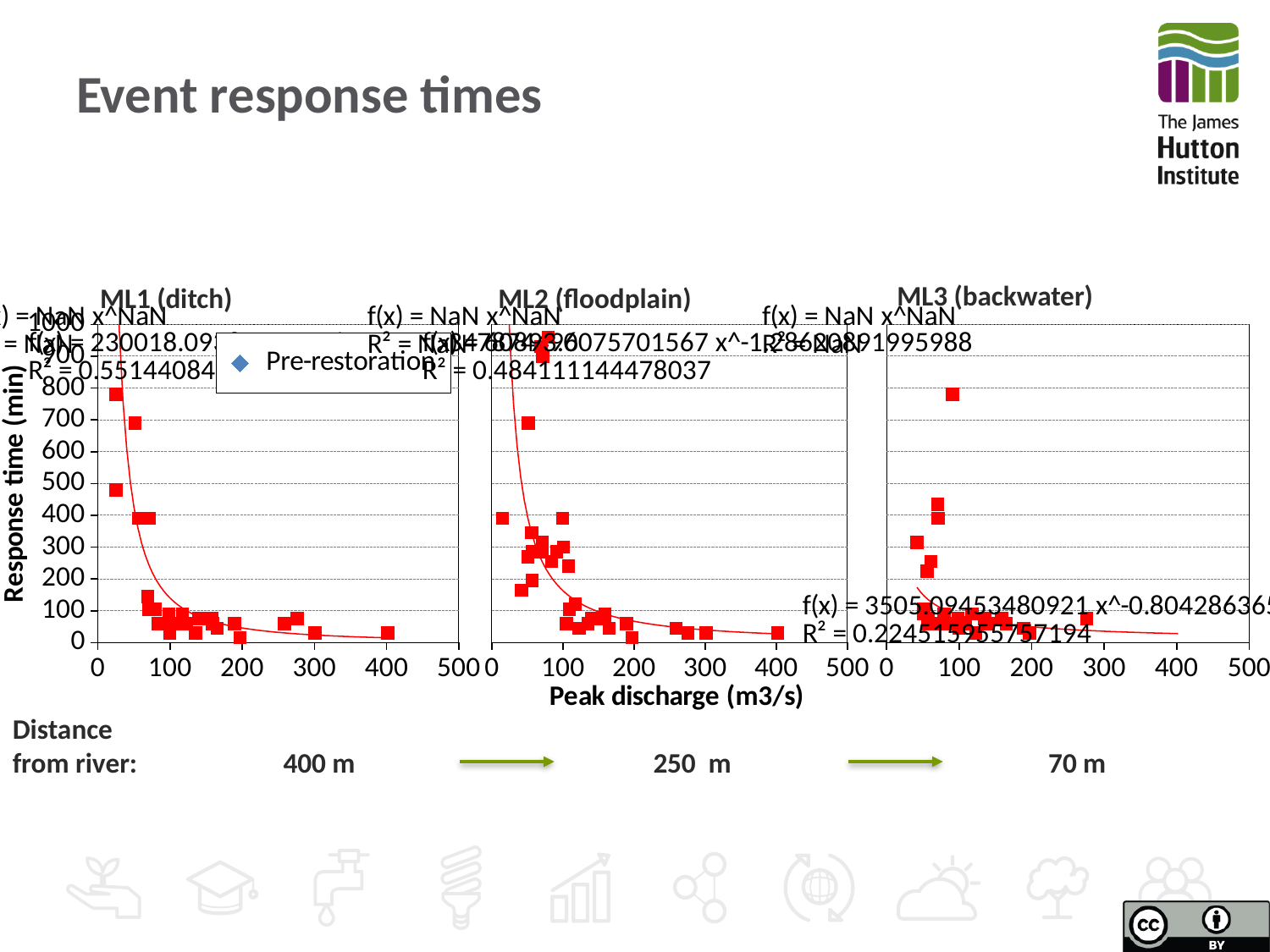
How many chart panels are shown on the slide? 3 What kind of chart is used for the ML1 (ditch), ML2 (floodplain) and ML3 (backwater) panels? scatter chart What R² value is printed for the trendline in the ML3 (backwater) chart? 0.224515955757194 What is the maximum value shown on the y-axis of the ML1 (ditch) chart? 1000 What R² value is printed for the trendline in the ML2 (floodplain) chart? 0.484111144478037 What is the x-axis title shared by the three charts? Peak discharge (m3/s) What is the y-axis title shared by the three charts? Response time (min) In the ML1 (ditch) chart, is the response time for the point at a peak discharge of about 400 m3/s greater or less than 100? less In the ML2 (floodplain) chart, is the highest response time value greater or less than 800? greater In the ML1 (ditch) chart, is the highest response time value greater or less than 700? greater In the ML2 (floodplain) chart, does response time generally rise or fall as peak discharge increases? fall